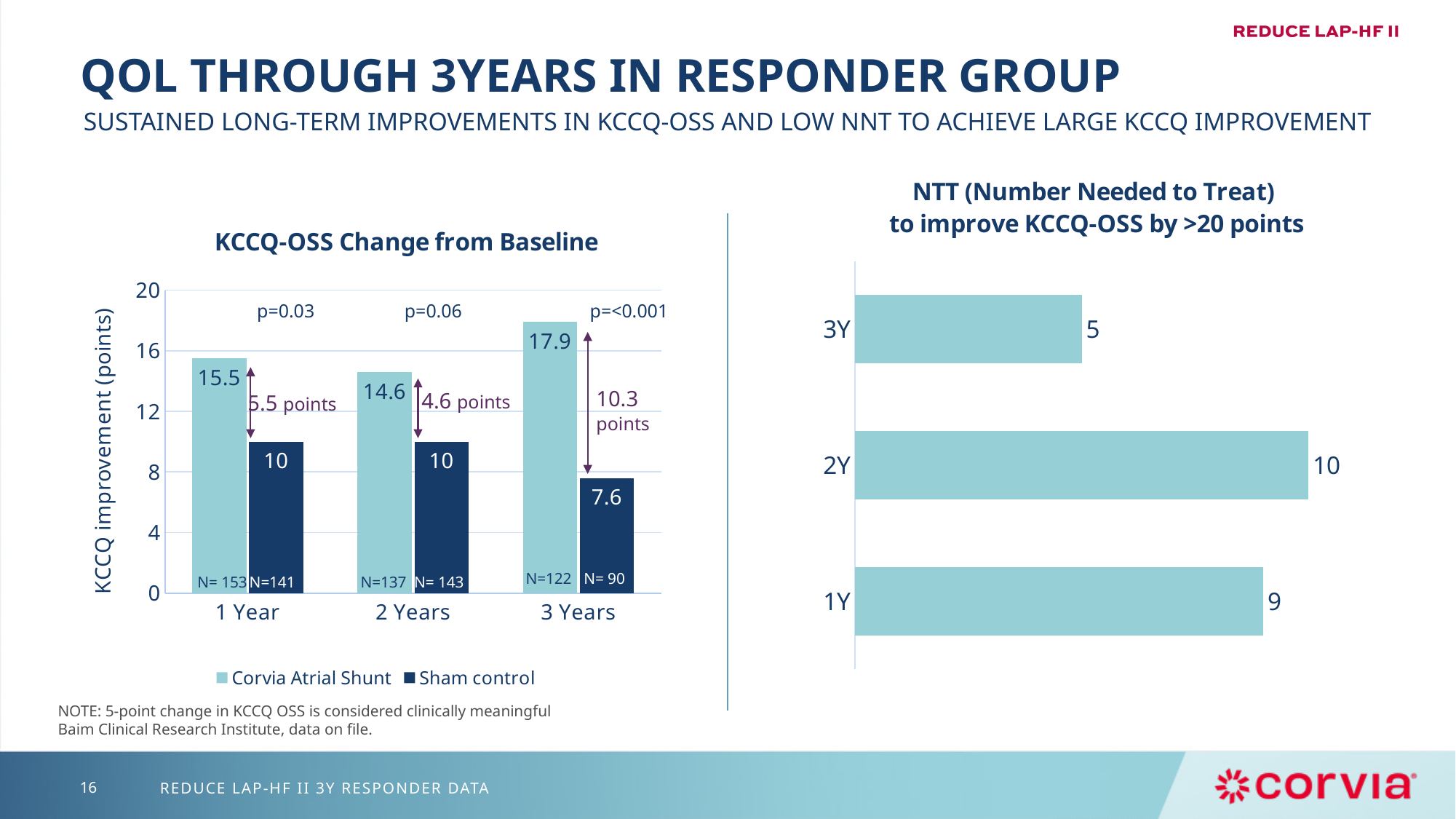
In the KCCQ-OSS Change from Baseline chart, what is the value for Sham control at 3 Years? 7.6 In the NTT chart on the right, what is the value for 2Y? 10 In the KCCQ-OSS Change from Baseline chart, what is the value for Sham control at 1 Year? 10 In the NTT chart on the right, how many categories are shown? 3 In the KCCQ-OSS Change from Baseline chart, what p-value is shown for 1 Year? p=0.03 In the KCCQ-OSS Change from Baseline chart, what is the value for Corvia Atrial Shunt at 3 Years? 17.9 What kind of chart is the NTT chart on the right? bar chart In the KCCQ-OSS Change from Baseline chart, which time point has the highest Corvia Atrial Shunt value? 3 Years In the NTT chart on the right, which category has the lowest value? 3Y In the KCCQ-OSS Change from Baseline chart, does the Sham control value rise or fall from 2 Years to 3 Years? fall In the KCCQ-OSS Change from Baseline chart, what is the difference between Corvia Atrial Shunt and Sham control at 2 Years? 4.6 points In the KCCQ-OSS Change from Baseline chart, how many series does the legend list? 2